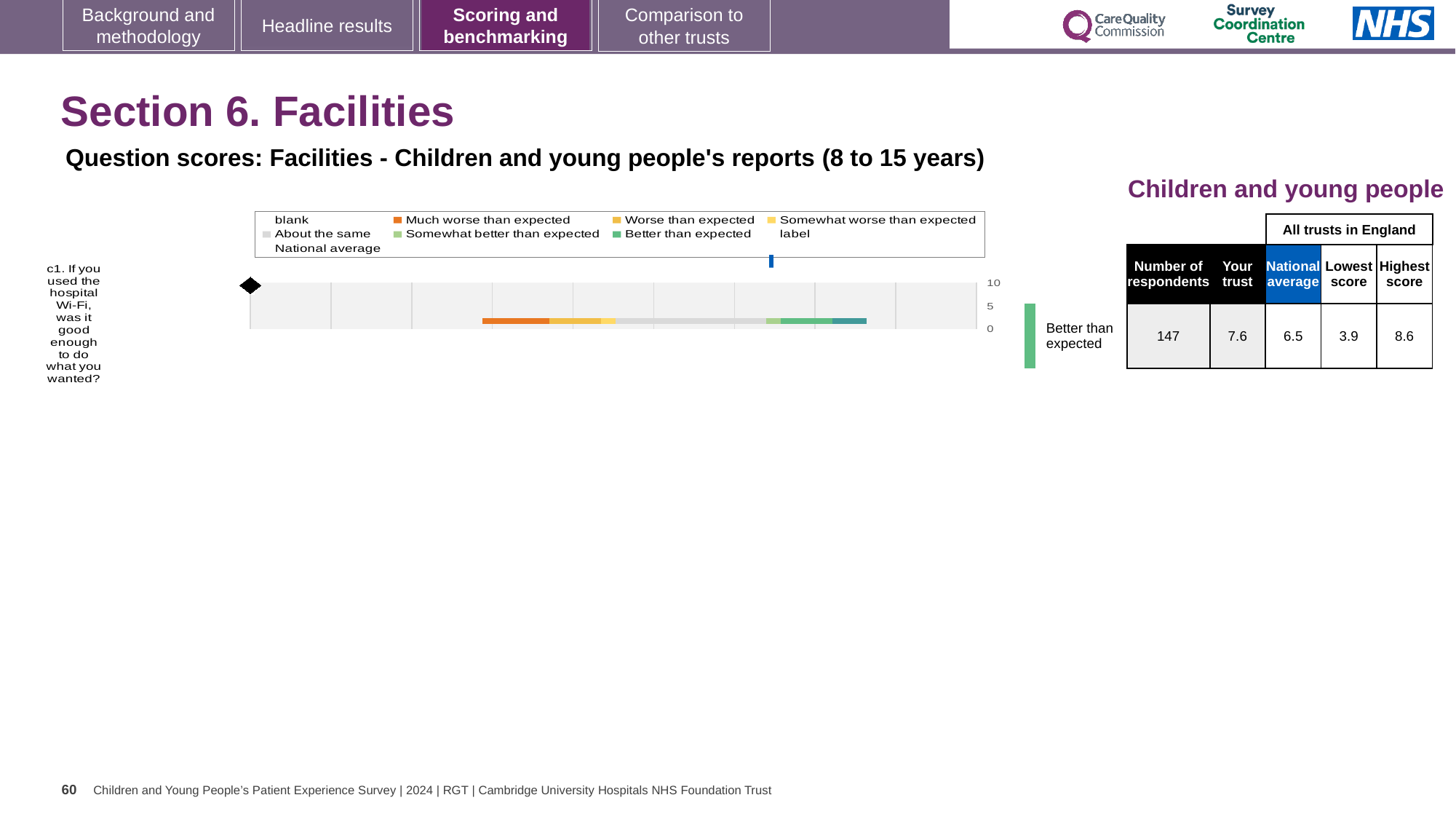
How is the trust's result for question c1 categorised on the slide? Better than expected According to the table beside the chart, what is the highest score among all trusts in England for question c1? 8.6 How many respondents answered question c1, according to the table beside the chart? 147 What type of chart is shown on the slide? bar chart Which survey question is plotted in the chart? c1. If you used the hospital Wi-Fi, was it good enough to do what you wanted? Which is larger for question c1: the 'Your trust' score or the national average? Your trust According to the table beside the chart, what is the national average score for question c1? 6.5 What is the difference between the 'Your trust' score and the national average for question c1? 1.1 According to the table beside the chart, what is the 'Your trust' score for question c1? 7.6 How many survey questions are plotted in the chart? 1 What is the difference between the highest and lowest scores among all trusts in England for question c1? 4.7 According to the table beside the chart, what is the lowest score among all trusts in England for question c1? 3.9